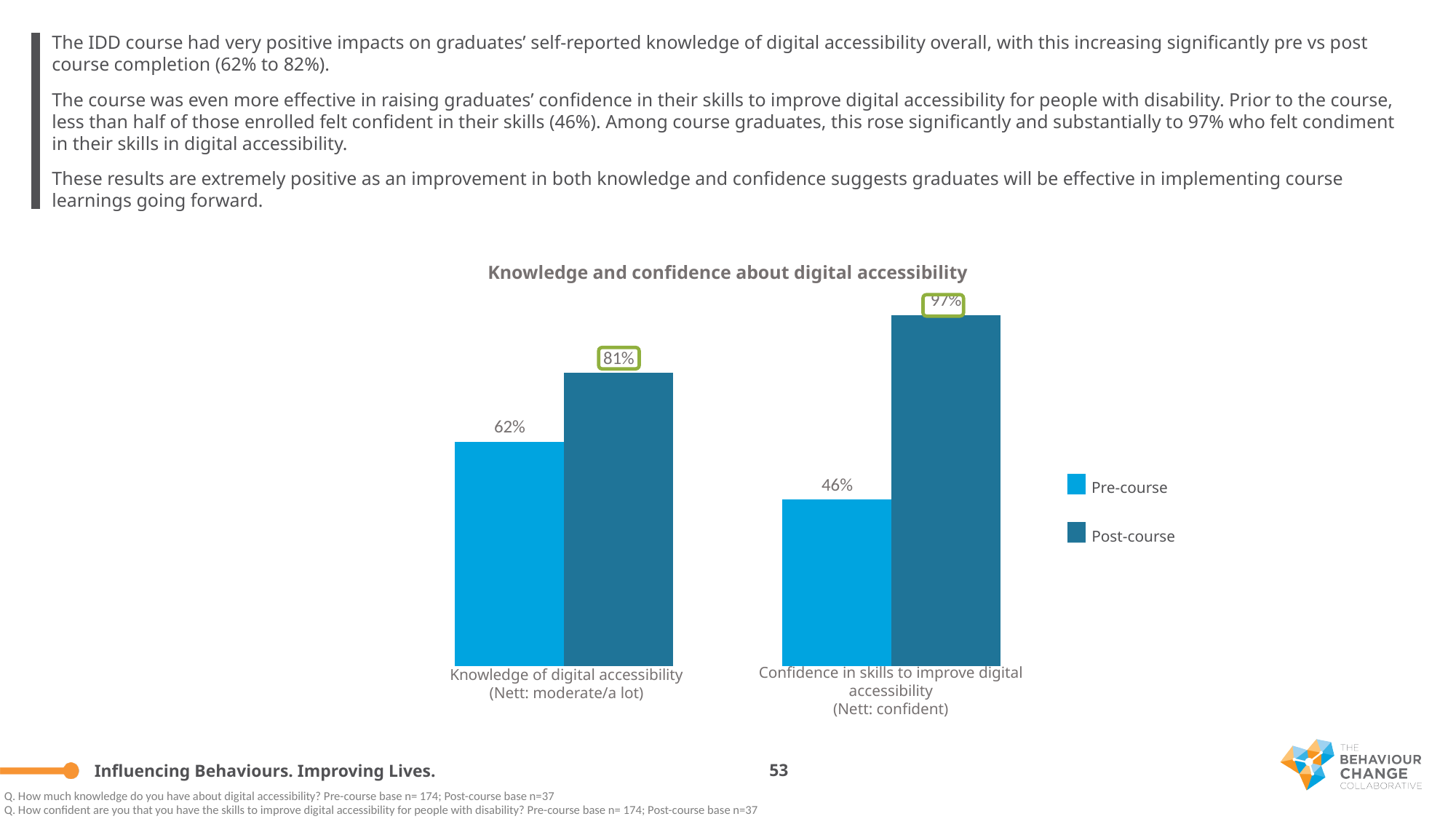
How many series does the chart legend list? 2 What is the Post-course value for Confidence in skills to improve digital accessibility (Nett: confident)? 97% What type of chart is shown on the slide? Bar chart What is the Pre-course value for Confidence in skills to improve digital accessibility (Nett: confident)? 46% What is the Pre-course value for Knowledge of digital accessibility (Nett: moderate/a lot)? 62% What is the difference between the Post-course and Pre-course values for Confidence in skills to improve digital accessibility? 51 percentage points Which bar in the chart has the lowest value? Pre-course, Confidence in skills to improve digital accessibility What is the Post-course value for Knowledge of digital accessibility (Nett: moderate/a lot)? 81% How many categories are shown on the x axis of the chart? 2 What is the difference between the Post-course and Pre-course values for Knowledge of digital accessibility? 19 percentage points Which is larger: the Pre-course value for Knowledge of digital accessibility or the Pre-course value for Confidence in skills to improve digital accessibility? Knowledge of digital accessibility Which bar in the chart has the highest value? Post-course, Confidence in skills to improve digital accessibility